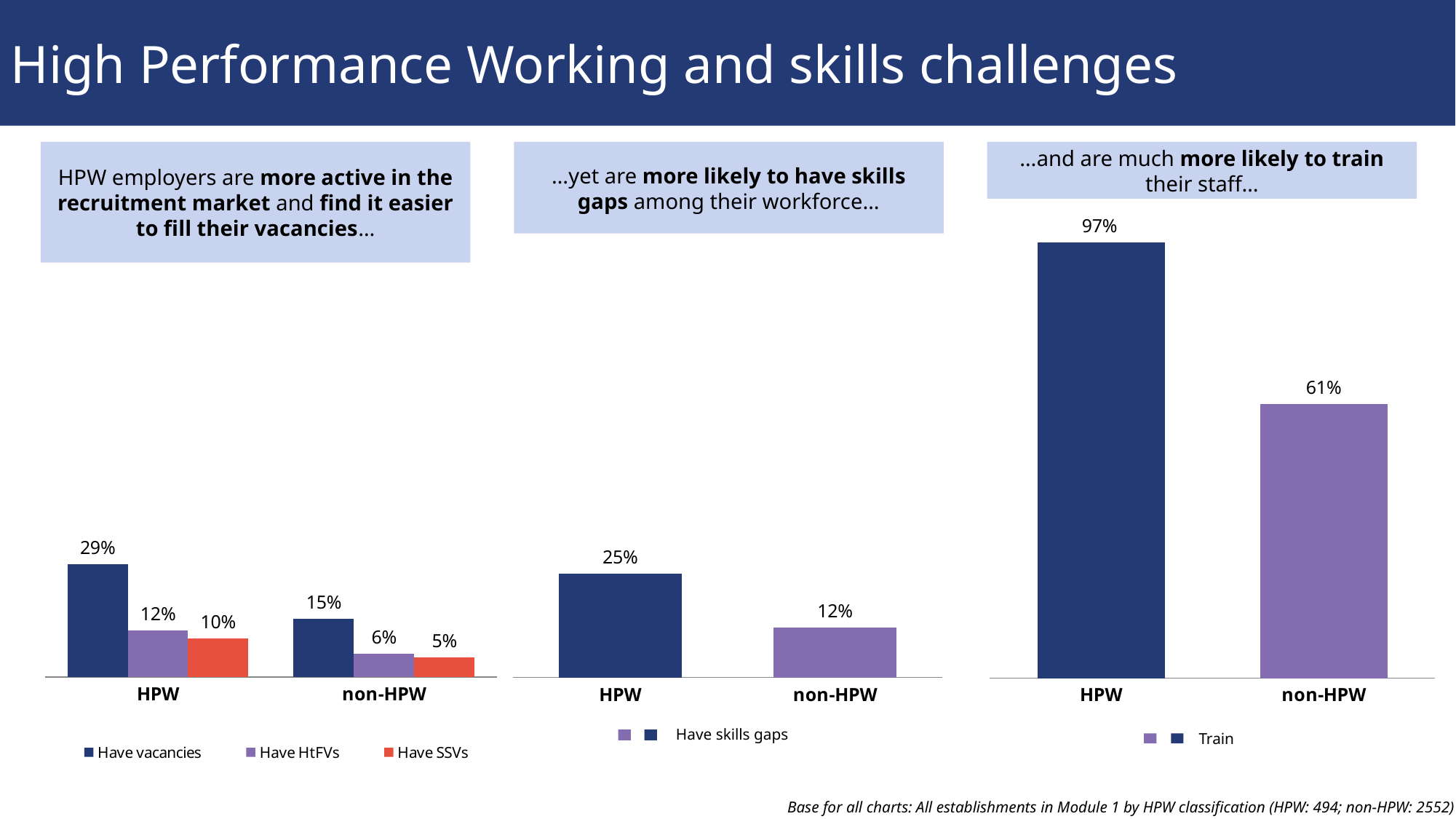
In the middle chart (skills gaps), what is the value for HPW? 25% In the right chart (train their staff), what is the legend entry? Train In the right chart (train their staff), what is the value for non-HPW? 61% In the right chart (train their staff), what kind of chart is shown? Bar chart In the left chart (recruitment market), what is the value for Have SSVs for non-HPW? 5% In the middle chart (skills gaps), which category has the lower value? non-HPW In the middle chart (skills gaps), what is the difference between HPW and non-HPW? 13% In the left chart (recruitment market), what is the value for Have vacancies for HPW? 29% In the left chart (recruitment market), what is the difference between Have HtFVs for HPW and Have HtFVs for non-HPW? 6% In the left chart (recruitment market), which bar is the highest? Have vacancies for HPW In the right chart (train their staff), what is the difference between HPW and non-HPW? 36% In the left chart (recruitment market), how many series does the legend list? 3